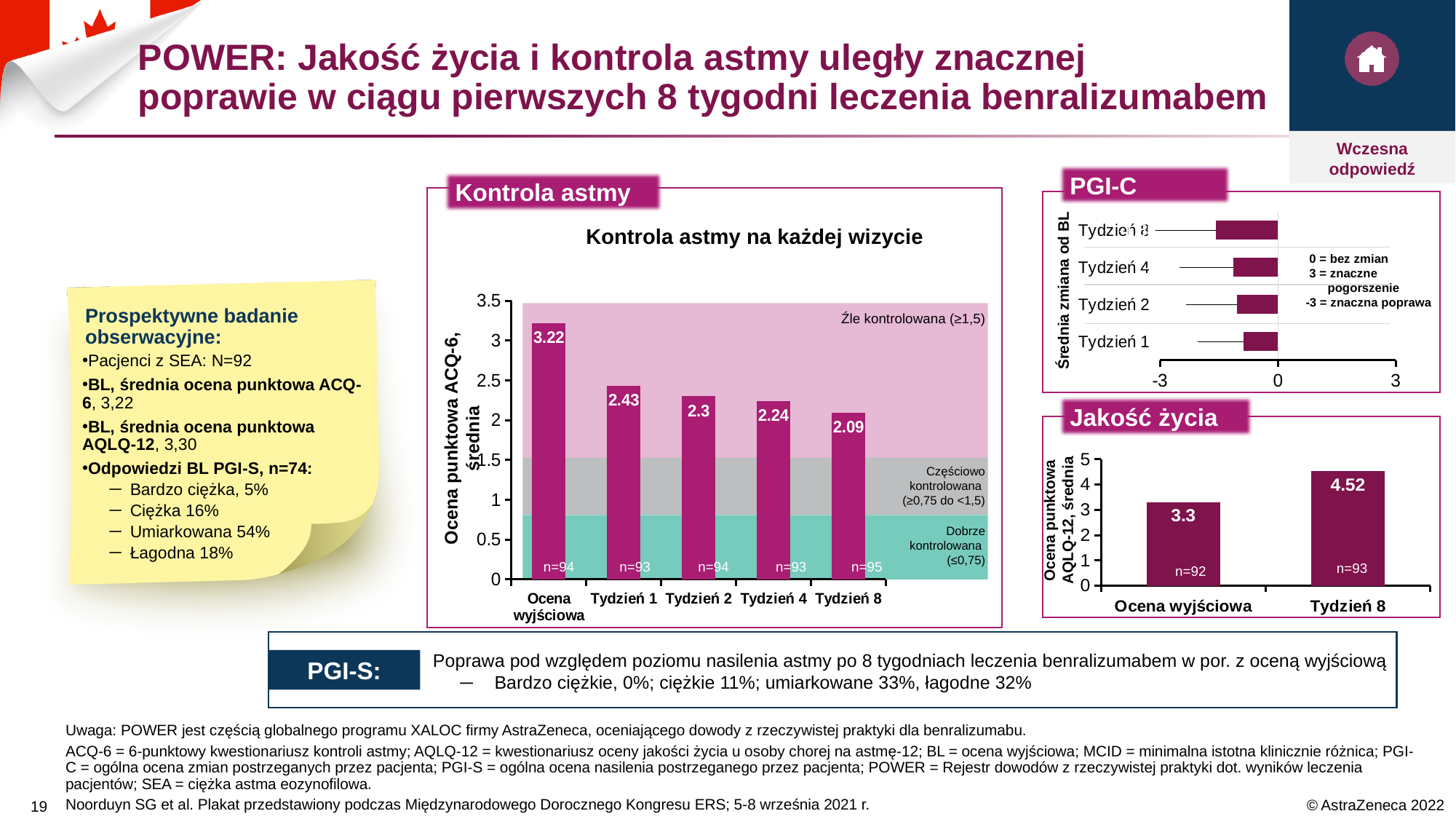
In the 'Jakość życia' chart, is the value for Ocena wyjściowa greater or less than 4? less In the 'Kontrola astmy na każdej wizycie' chart, do the ACQ-6 scores rise or fall from Ocena wyjściowa to Tydzień 8? fall What kind of chart is the PGI-C chart? bar chart In the 'Kontrola astmy na każdej wizycie' chart, how many visits are plotted on the x axis? 5 In the 'Kontrola astmy na każdej wizycie' chart, what is the ACQ-6 mean score at Tydzień 8? 2.09 In the 'Jakość życia' chart, what is the AQLQ-12 mean score at Tydzień 8? 4.52 In the PGI-C chart, is the value for Tydzień 8 greater or less than 0? less In the 'Kontrola astmy na każdej wizycie' chart, which visit has the lowest ACQ-6 mean score? Tydzień 8 In the 'Jakość życia' chart, what is the difference between the AQLQ-12 score at Tydzień 8 and at Ocena wyjściowa? 1.22 In the 'Kontrola astmy na każdej wizycie' chart, what is the n value shown for Tydzień 8? n=95 In the 'Kontrola astmy na każdej wizycie' chart, what is the difference between the ACQ-6 score at Ocena wyjściowa and at Tydzień 8? 1.13 In the 'Kontrola astmy na każdej wizycie' chart, what is the ACQ-6 mean score at Ocena wyjściowa? 3.22